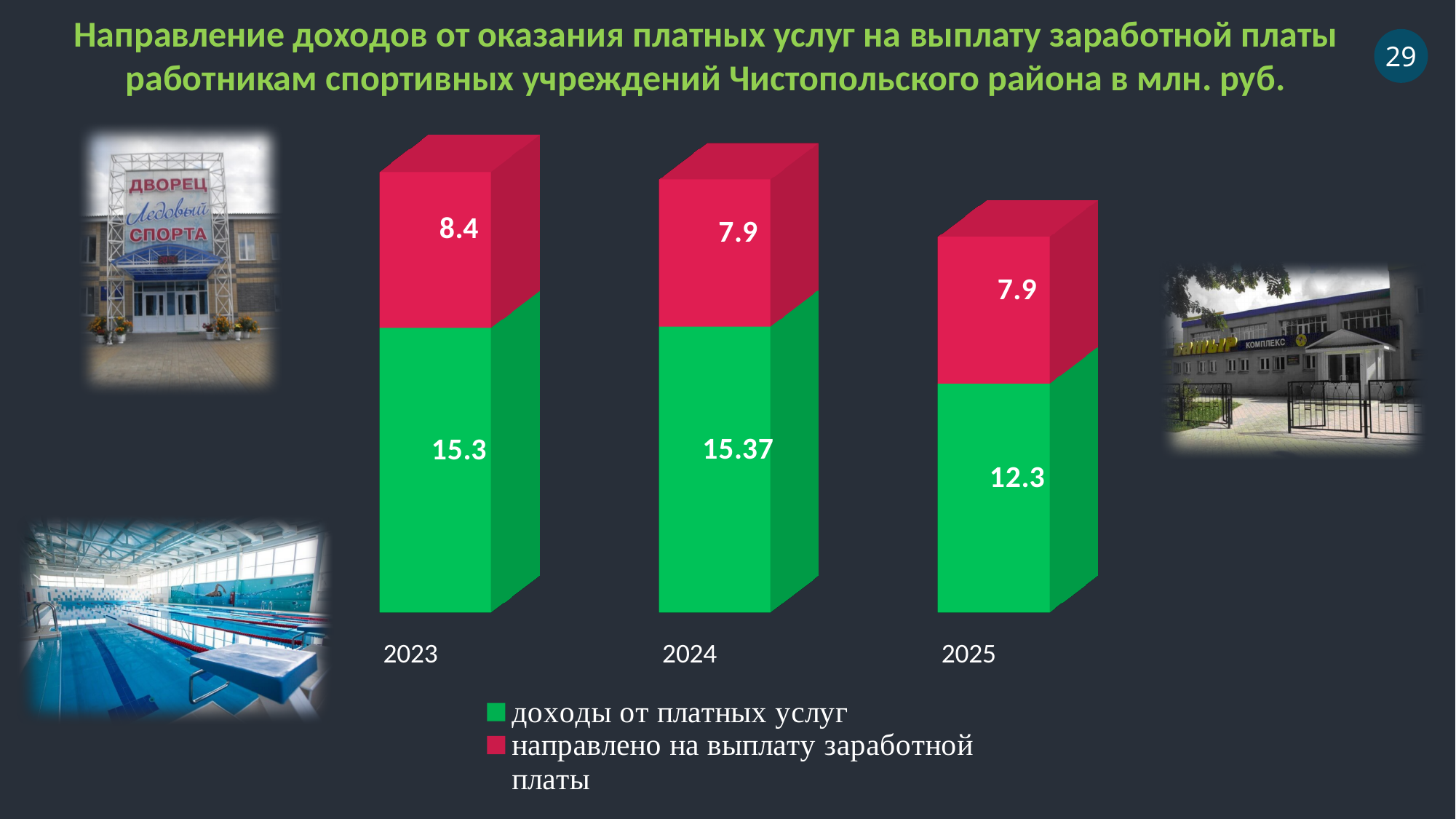
What is the difference between "доходы от платных услуг" in 2023 and 2025? 3 What is the difference between "направлено на выплату заработной платы" in 2023 and 2024? 0.5 How many years are shown on the x axis? 3 What is the total of the stacked bar for 2025? 20.2 What is the value of "доходы от платных услуг" for 2023? 15.3 What kind of chart is shown on the slide? Stacked bar chart In which year is "направлено на выплату заработной платы" the highest? 2023 Which is larger: "доходы от платных услуг" in 2024 or in 2025? 2024 In which year is "доходы от платных услуг" the lowest? 2025 What is the value of "доходы от платных услуг" for 2025? 12.3 What is the value of "направлено на выплату заработной платы" for 2024? 7.9 How many series does the legend list? 2